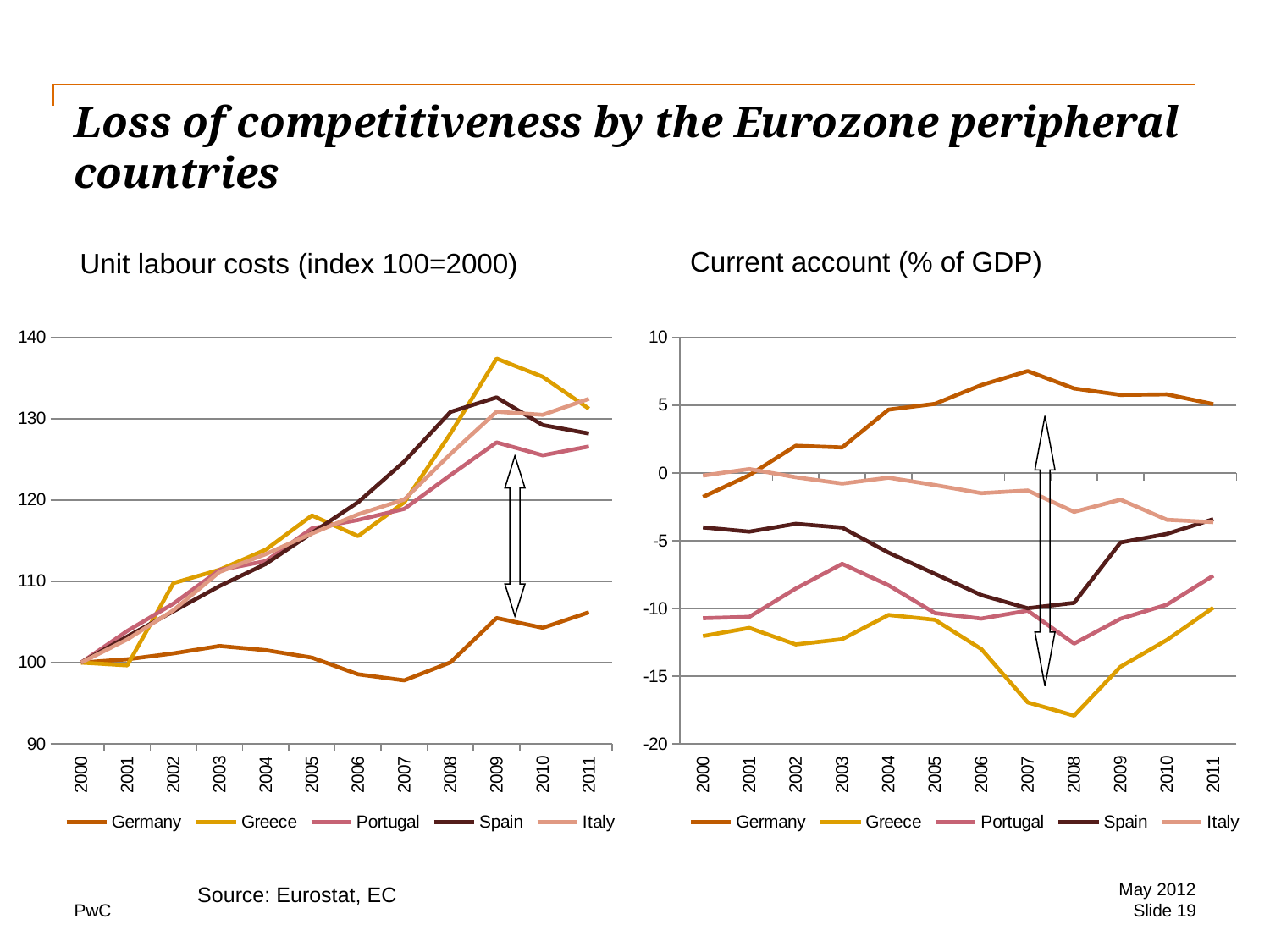
In the 'Unit labour costs (index 100=2000)' chart, which country has the highest value in 2009? Greece In the 'Unit labour costs (index 100=2000)' chart, is the value for Greece in 2009 greater or less than 130? greater How many series does the legend of the 'Current account (% of GDP)' chart list? 5 In the 'Current account (% of GDP)' chart, does the value for Germany rise or fall from 2000 to 2007? rise What type of chart is the 'Unit labour costs (index 100=2000)' chart? line chart In the 'Current account (% of GDP)' chart, which country has the lowest value in 2008? Greece In the 'Current account (% of GDP)' chart, which country has the highest value in 2007? Germany How many years are shown on the x axis of the 'Unit labour costs (index 100=2000)' chart? 12 In the 'Unit labour costs (index 100=2000)' chart, which country has the lowest value in 2011? Germany In the 'Unit labour costs (index 100=2000)' chart, is the value for Germany in 2007 greater or less than 100? less In the 'Unit labour costs (index 100=2000)' chart, what is the value for Germany in 2000? 100 In the 'Current account (% of GDP)' chart, is the value for Greece in 2008 greater or less than -15? less